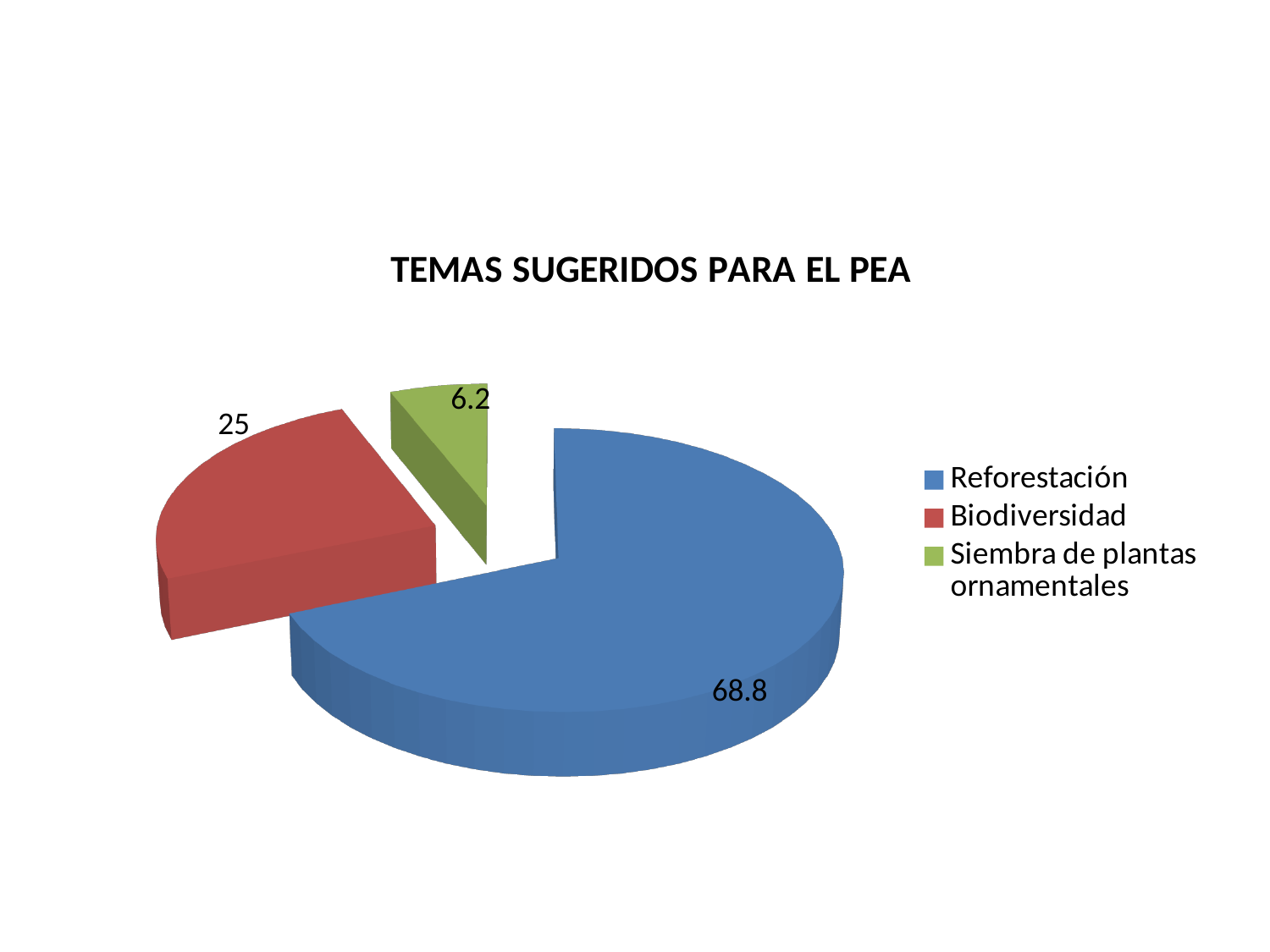
What is the title of the chart? TEMAS SUGERIDOS PARA EL PEA Which category has the largest slice? Reforestación Which category has the smallest slice? Siembra de plantas ornamentales What is the value for Biodiversidad? 25 What is the value for Siembra de plantas ornamentales? 6.2 Which colour represents Biodiversidad in the chart? Red How many categories does the pie chart show? 3 What is the value for Reforestación? 68.8 Which is larger, the value for Biodiversidad or the value for Siembra de plantas ornamentales? Biodiversidad What kind of chart is shown on the slide? Pie chart What is the difference between the values for Biodiversidad and Siembra de plantas ornamentales? 18.8 What is the difference between the values for Reforestación and Biodiversidad? 43.8